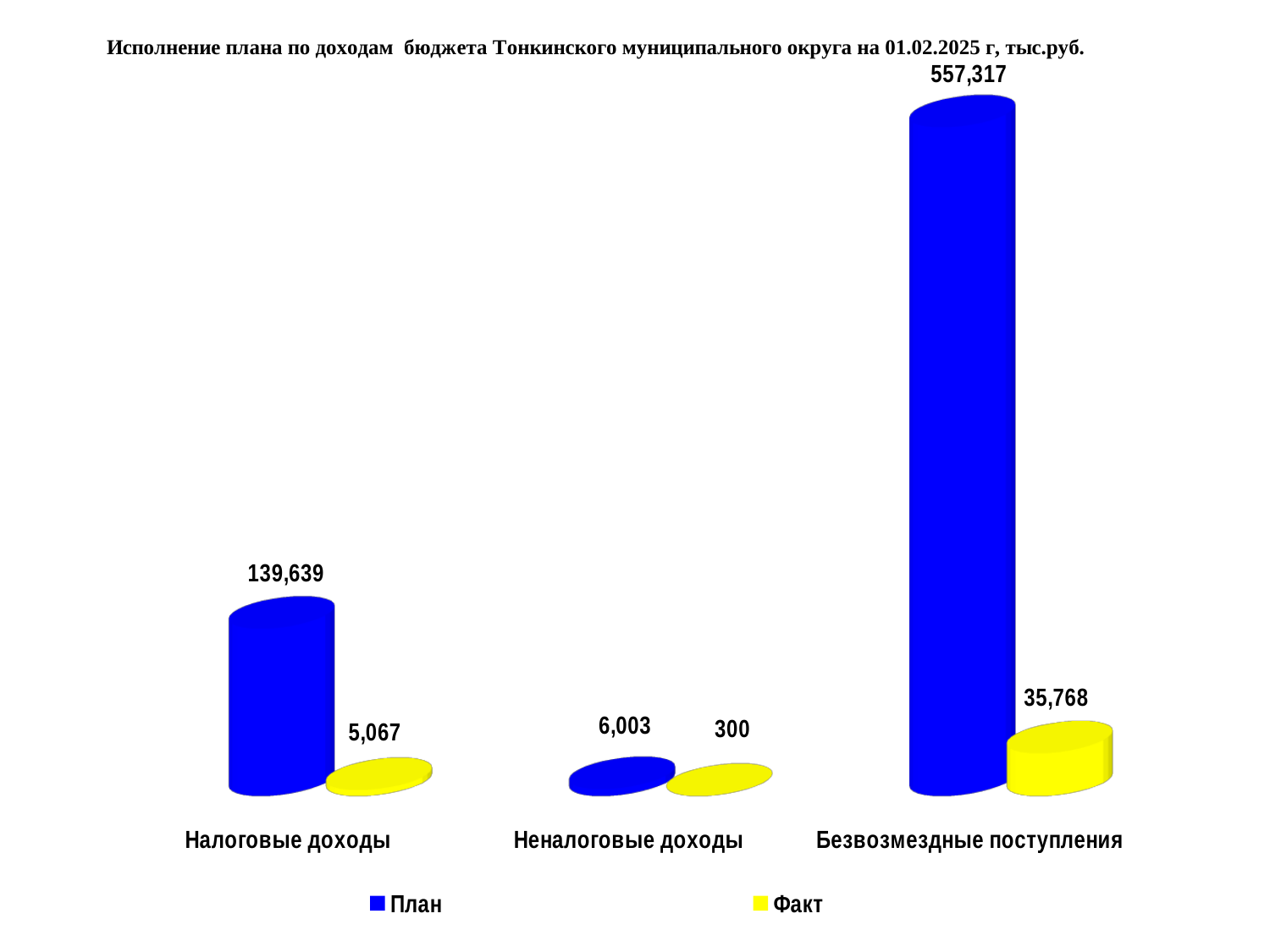
What kind of chart is shown on the slide? Bar chart How many series does the legend list? 2 What is the difference between the План and Факт values for Налоговые доходы? 134,572 What is the Факт value for Безвозмездные поступления? 35,768 Which is larger: the Факт value for Налоговые доходы or the Факт value for Безвозмездные поступления? Безвозмездные поступления What is the Факт value for Неналоговые доходы? 300 Which category has the lowest Факт value? Неналоговые доходы Which category has the highest План value? Безвозмездные поступления What is the План value for Неналоговые доходы? 6,003 What is the difference between the План and Факт values for Безвозмездные поступления? 521,549 How many categories are shown on the x axis? 3 What is the План value for Налоговые доходы? 139,639